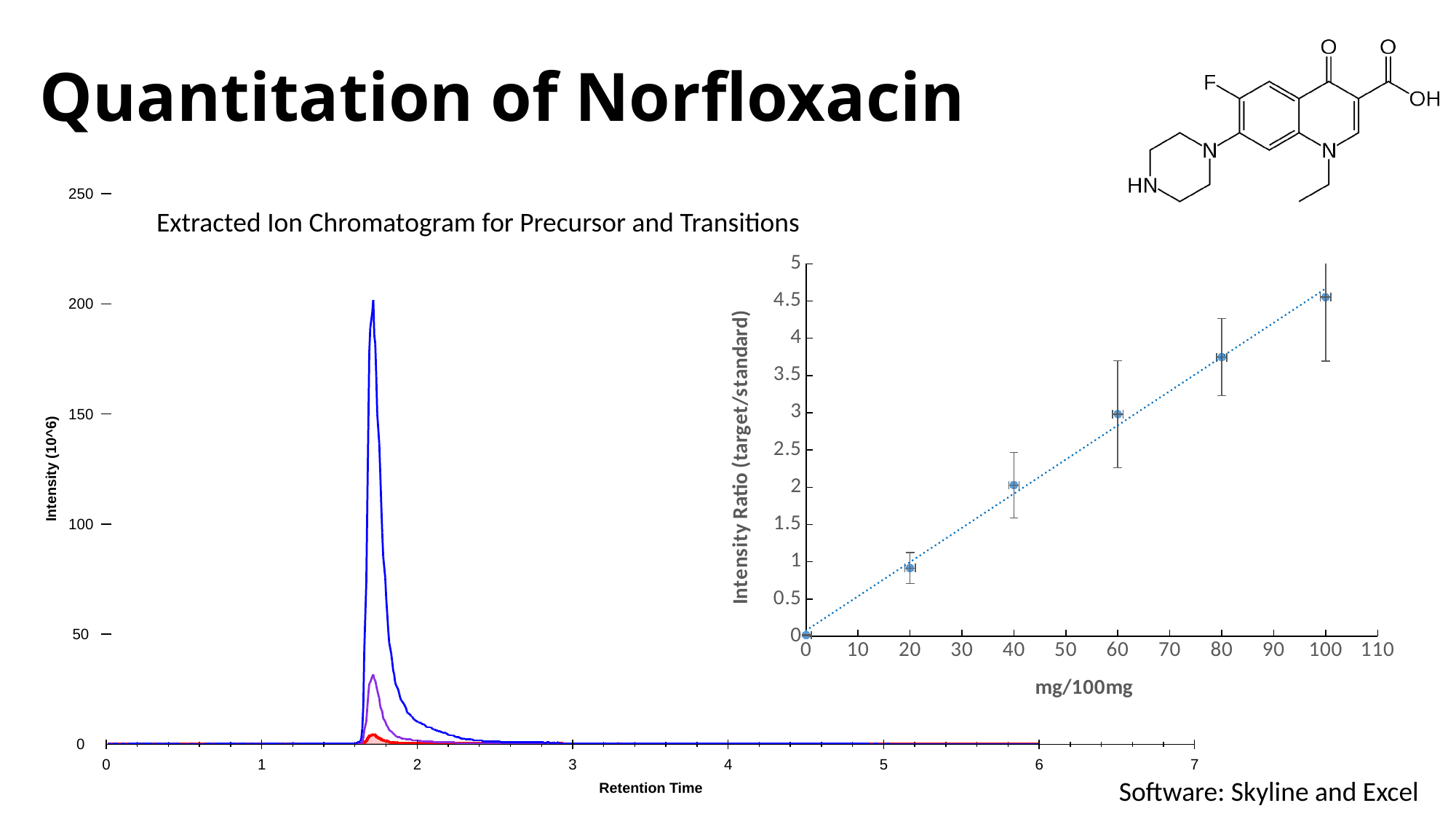
In the calibration plot on the right, does the intensity ratio rise or fall as mg/100mg increases? rises In the calibration plot on the right, how many data points are plotted? 6 In the Extracted Ion Chromatogram, is the peak intensity of the purple trace greater or less than 50? less In the calibration plot on the right, is the intensity ratio at 100 mg/100mg greater or less than 4? greater In the calibration plot on the right, which x value has the highest intensity ratio? 100 In the calibration plot on the right, what is the x-axis label? mg/100mg In the Extracted Ion Chromatogram, is the peak intensity of the blue trace greater or less than 150? greater In the calibration plot on the right, what is the y-axis label? Intensity Ratio (target/standard) What kind of chart is the Extracted Ion Chromatogram on the left? line chart What kind of chart is the calibration plot on the right (Intensity Ratio vs mg/100mg)? scatter plot